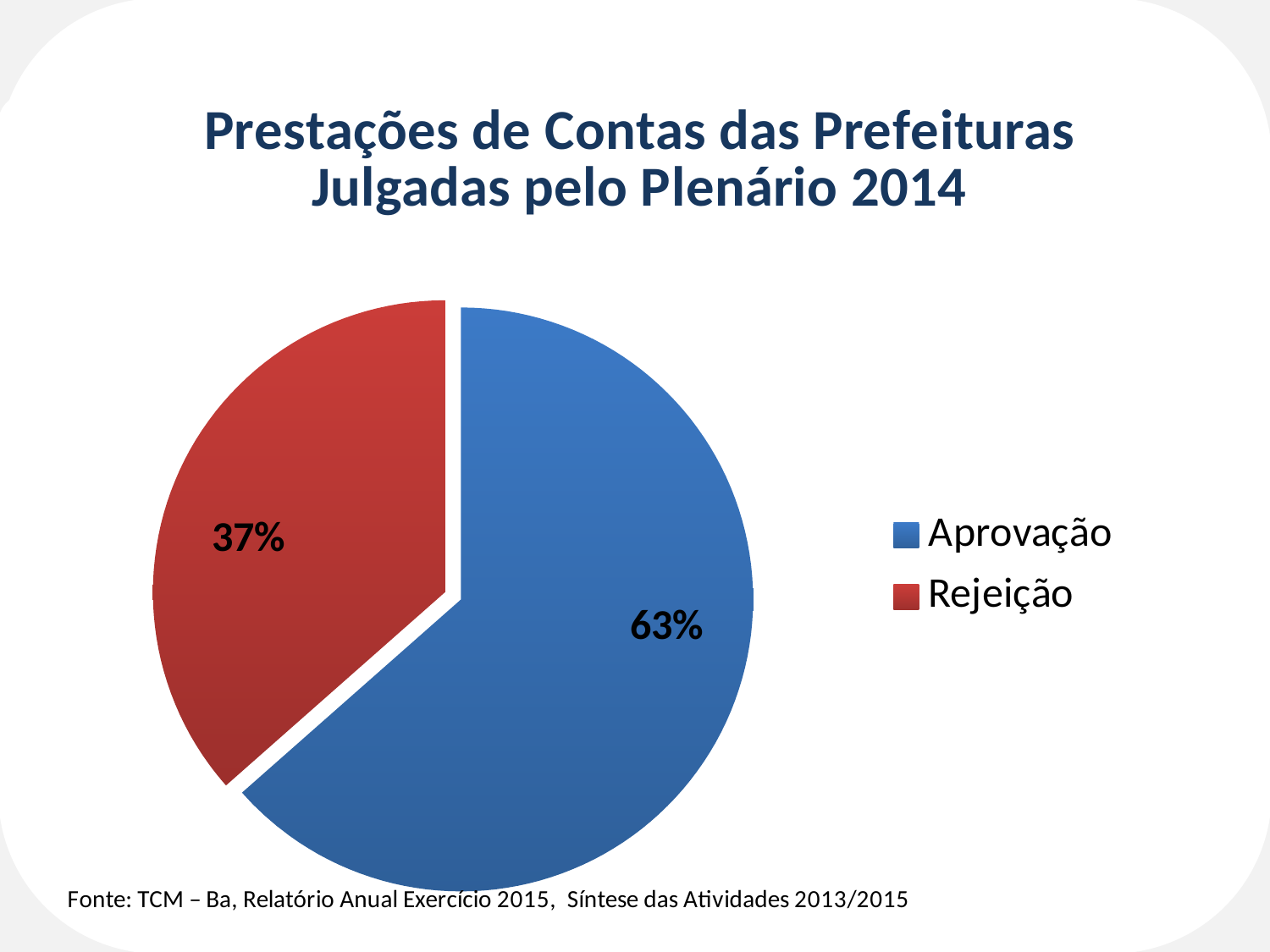
What colour is the Rejeição slice? Red Which category has the largest slice of the pie? Aprovação What share of the pie does Aprovação represent? 63% How many entries does the legend list? 2 Which category has the smallest slice of the pie? Rejeição Which is larger, the Aprovação slice or the Rejeição slice? Aprovação What is the difference in percentage points between Aprovação and Rejeição? 26 Is the share for Rejeição greater or less than 50%? less What is the title of the chart? Prestações de Contas das Prefeituras Julgadas pelo Plenário 2014 What share of the pie does Rejeição represent? 37% How many categories are shown in the pie chart? 2 What kind of chart is shown on the slide? Pie chart